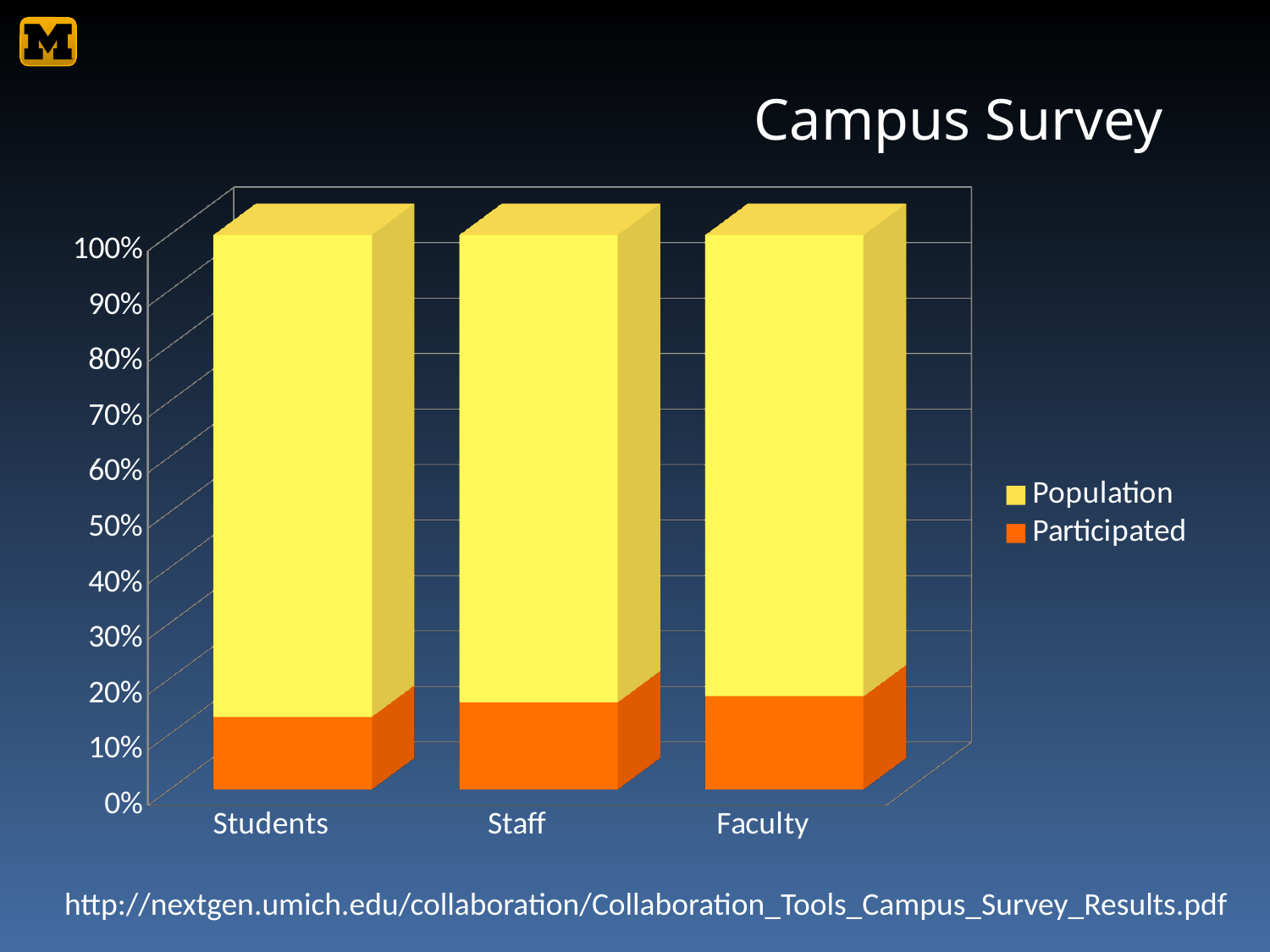
What is the title of the chart? Campus Survey What kind of chart is shown on the slide? Stacked bar chart How many series does the chart legend list? 2 Is the Participated value for Faculty greater or less than 30%? less Is the Participated value for Students greater or less than 10%? greater Which series is shown in orange in the chart? Participated Is the Participated value for Staff greater or less than 10%? greater What is the total height of the stacked bar for Students? 100% What is the total height of the stacked bar for Faculty? 100% How many categories are shown on the x axis of the chart? 3 Which has the larger Participated value, Students or Faculty? Faculty